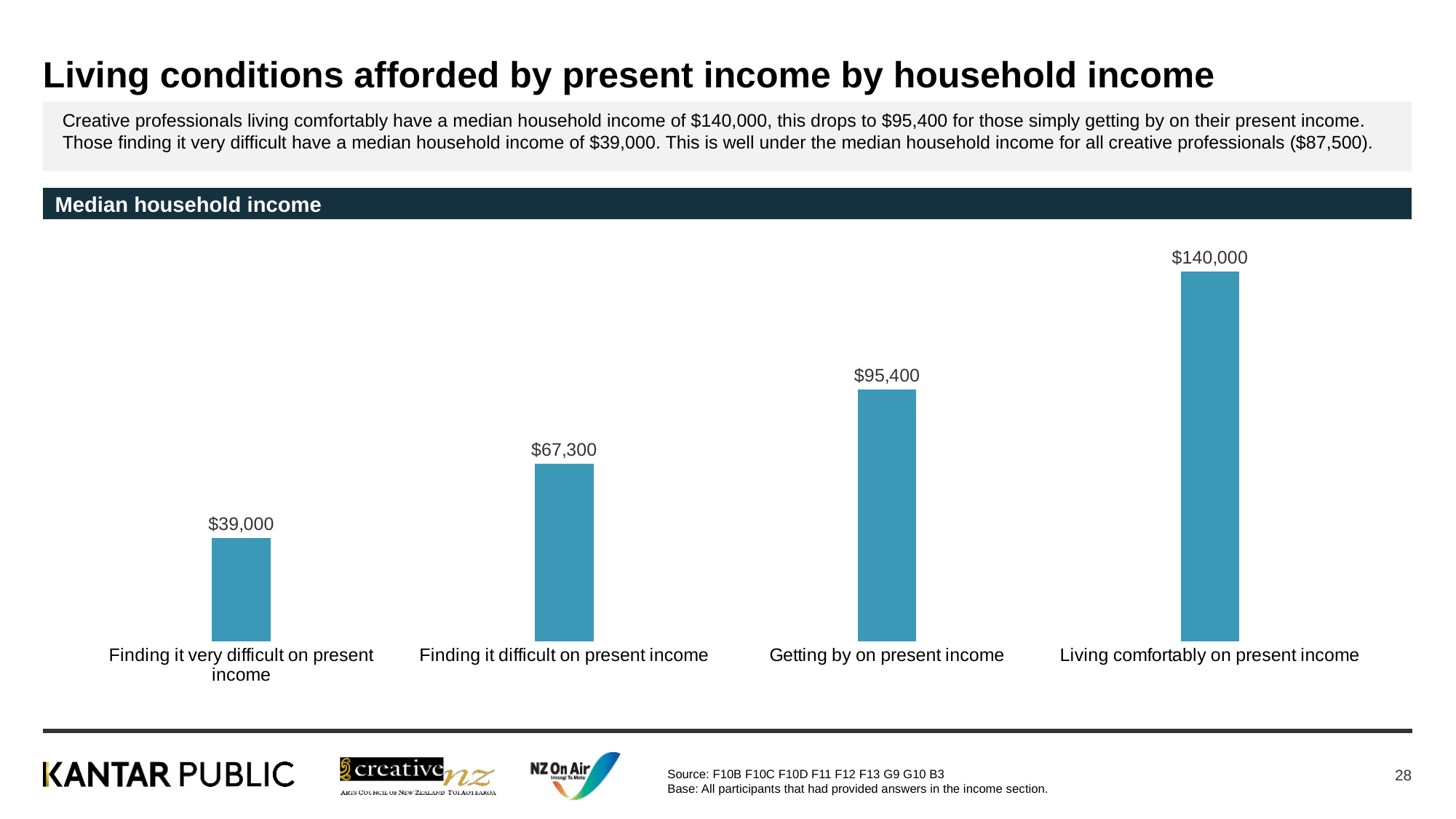
Do the values rise or fall moving from left to right across the categories? Rise How many categories are shown in the chart? 4 What is the median household income for those finding it very difficult on present income? $39,000 What kind of chart is shown on the slide? Bar chart What is the median household income for those living comfortably on present income? $140,000 What is the median household income for those finding it difficult on present income? $67,300 What is the median household income for those getting by on present income? $95,400 Which category has the lowest median household income? Finding it very difficult on present income What is the difference in median household income between those living comfortably and those finding it very difficult on present income? $101,000 What is the difference in median household income between those getting by and those finding it difficult on present income? $28,100 Which has a higher median household income: getting by on present income or finding it difficult on present income? Getting by on present income Which category has the highest median household income? Living comfortably on present income